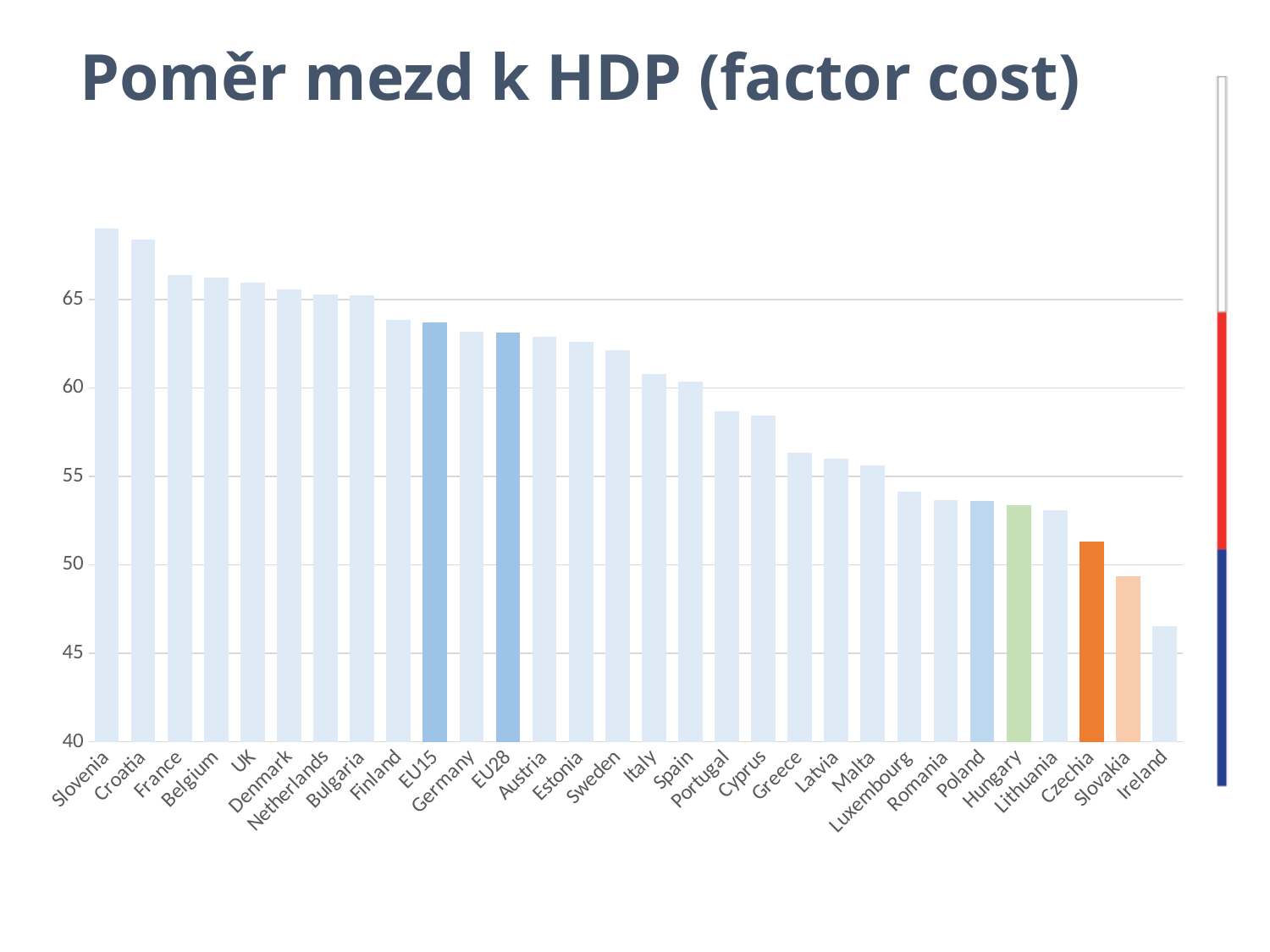
Is the value for Portugal greater or less than 60? less Is the value for Czechia greater or less than 50? greater How many bars are plotted in the chart? 30 Which has the larger value, Czechia or Slovakia? Czechia What kind of chart is shown on the slide? bar chart Do the values rise or fall moving from left to right along the x axis? fall Is the value for Slovenia greater or less than 65? greater Which has the larger value, Poland or Czechia? Poland What is the title of the chart? Poměr mezd k HDP (factor cost) Which country has the lowest value in the chart? Ireland Which country has the highest value in the chart? Slovenia